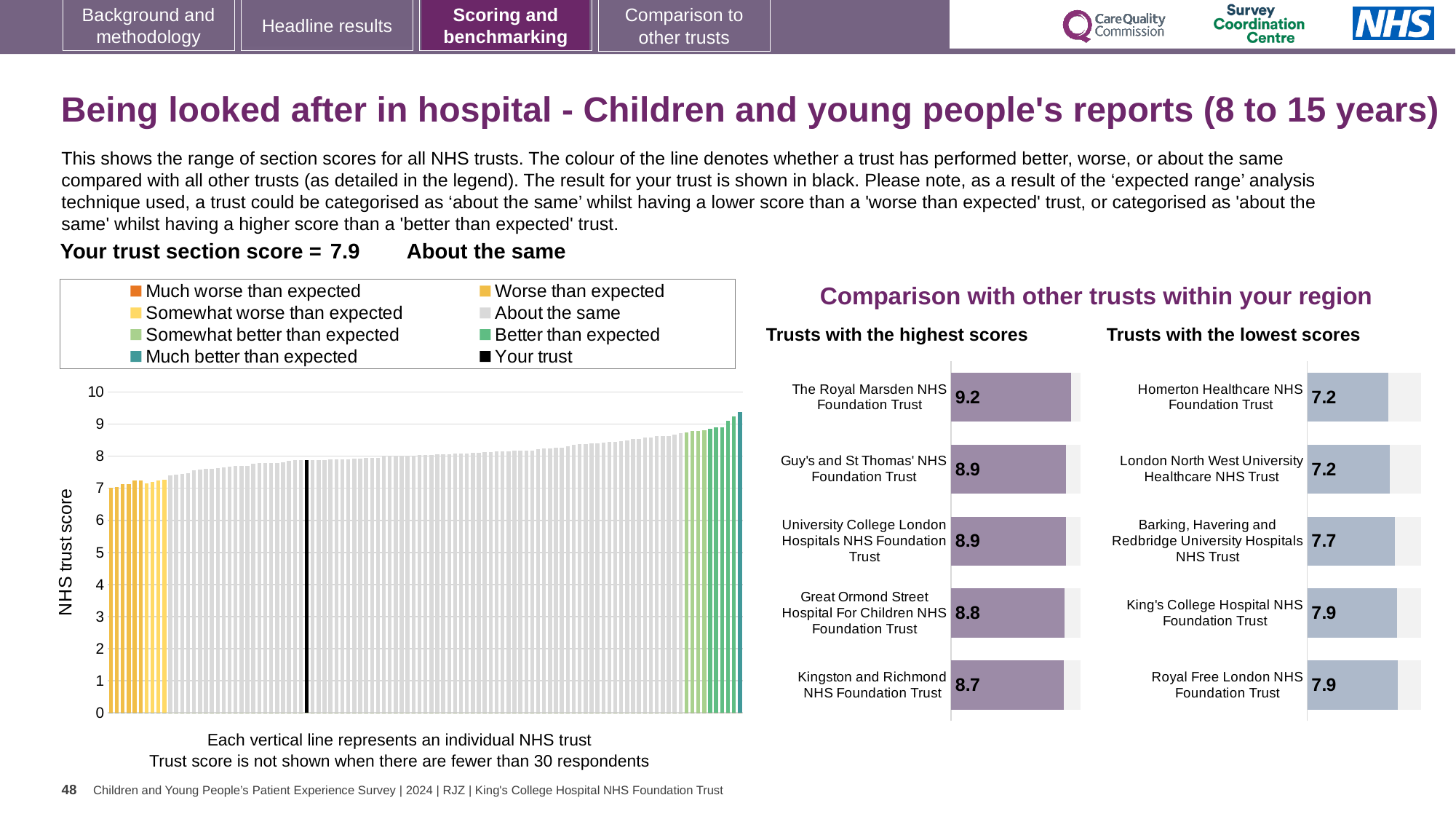
In the 'Trusts with the highest scores' chart, which trust has the highest score? The Royal Marsden NHS Foundation Trust In the main chart on the left showing all NHS trusts, how many entries does the legend list? 8 In the 'Trusts with the highest scores' chart, what is the difference between the scores of The Royal Marsden NHS Foundation Trust and Kingston and Richmond NHS Foundation Trust? 0.5 In the 'Trusts with the highest scores' chart, what is the score for The Royal Marsden NHS Foundation Trust? 9.2 In the main chart on the left showing all NHS trusts, what is the label of the vertical axis? NHS trust score In the 'Trusts with the lowest scores' chart, which has the larger score: Barking, Havering and Redbridge University Hospitals NHS Trust or Homerton Healthcare NHS Foundation Trust? Barking, Havering and Redbridge University Hospitals NHS Trust In the main chart on the left showing all NHS trusts, what kind of chart is it? Bar chart In the 'Trusts with the lowest scores' chart, how many trusts are shown? 5 In the 'Trusts with the lowest scores' chart, what is the difference between the scores of King's College Hospital NHS Foundation Trust and Homerton Healthcare NHS Foundation Trust? 0.7 In the 'Trusts with the lowest scores' chart, what is the score for Barking, Havering and Redbridge University Hospitals NHS Trust? 7.7 In the 'Trusts with the highest scores' chart, which trust has the lowest score? Kingston and Richmond NHS Foundation Trust In the 'Trusts with the lowest scores' chart, what is the score for Homerton Healthcare NHS Foundation Trust? 7.2